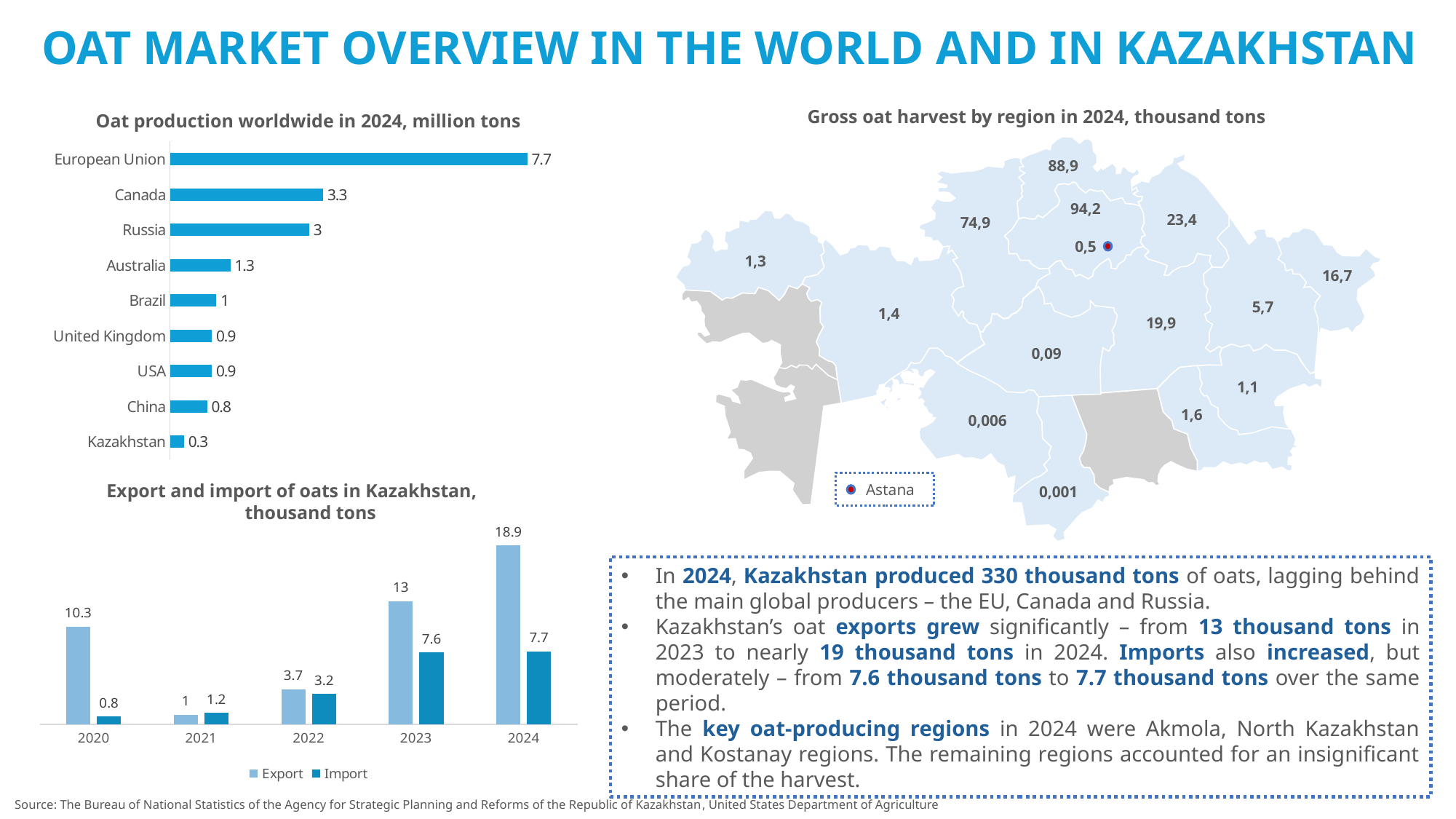
In the 'Oat production worldwide in 2024, million tons' chart, which category has the lowest value? Kazakhstan In the 'Export and import of oats in Kazakhstan, thousand tons' chart, what is the Import value for 2022? 3.2 In the 'Oat production worldwide in 2024, million tons' chart, how many categories are shown? 9 In the 'Export and import of oats in Kazakhstan, thousand tons' chart, how many series does the legend list? 2 In the 'Oat production worldwide in 2024, million tons' chart, what is the difference between the European Union and Russia? 4.7 In the 'Export and import of oats in Kazakhstan, thousand tons' chart, do Export values rise or fall from 2021 to 2024? Rise In the 'Oat production worldwide in 2024, million tons' chart, what is the value for Canada? 3.3 In the 'Export and import of oats in Kazakhstan, thousand tons' chart, what is the Export value for 2023? 13 What kind of chart is 'Oat production worldwide in 2024, million tons'? Bar chart In the 'Export and import of oats in Kazakhstan, thousand tons' chart, what is the difference between Export and Import in 2024? 11.2 In the 'Export and import of oats in Kazakhstan, thousand tons' chart, which is larger in 2021, Export or Import? Import In the 'Oat production worldwide in 2024, million tons' chart, which category has the highest value? European Union